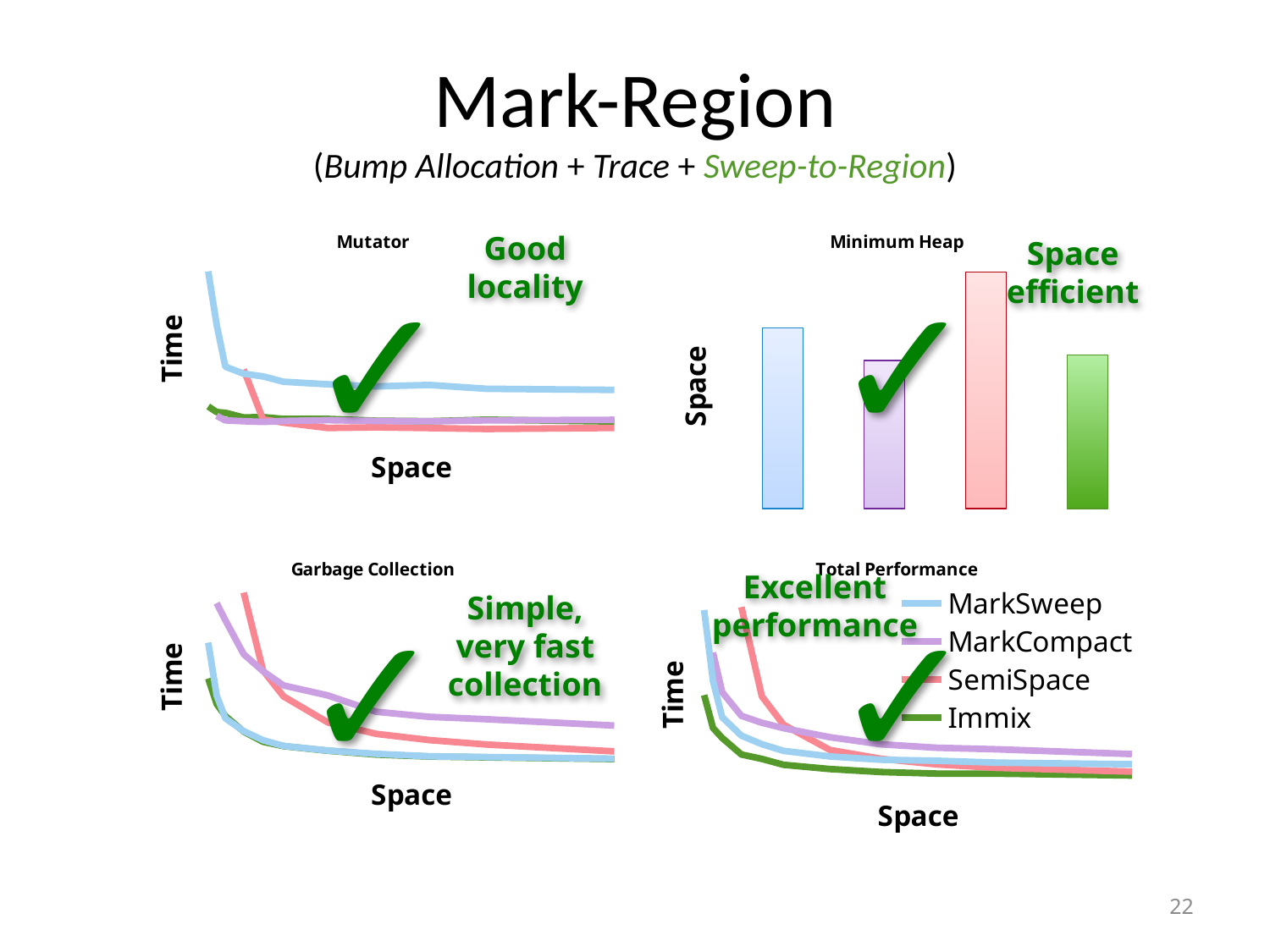
Which series in the Total Performance legend is shown in green? Immix In the Total Performance chart, which series has the lowest line at the right-hand end? Immix What kind of chart is the Minimum Heap chart? bar chart How many series does the legend on the Total Performance chart list? 4 How many bars are shown in the Minimum Heap chart? 4 In the Total Performance chart, does the Immix line rise or fall as Space increases? fall In the Minimum Heap chart, which series (by legend colour) has the shortest bar? MarkCompact What is the label on the vertical axis of the Mutator chart? Time In the Minimum Heap chart, is the red bar taller or shorter than the blue bar? taller What kind of chart is the Total Performance chart? line chart In the Minimum Heap chart, which series (by legend colour) has the tallest bar? SemiSpace In the Garbage Collection chart, does the purple MarkCompact line rise or fall as Space increases? fall